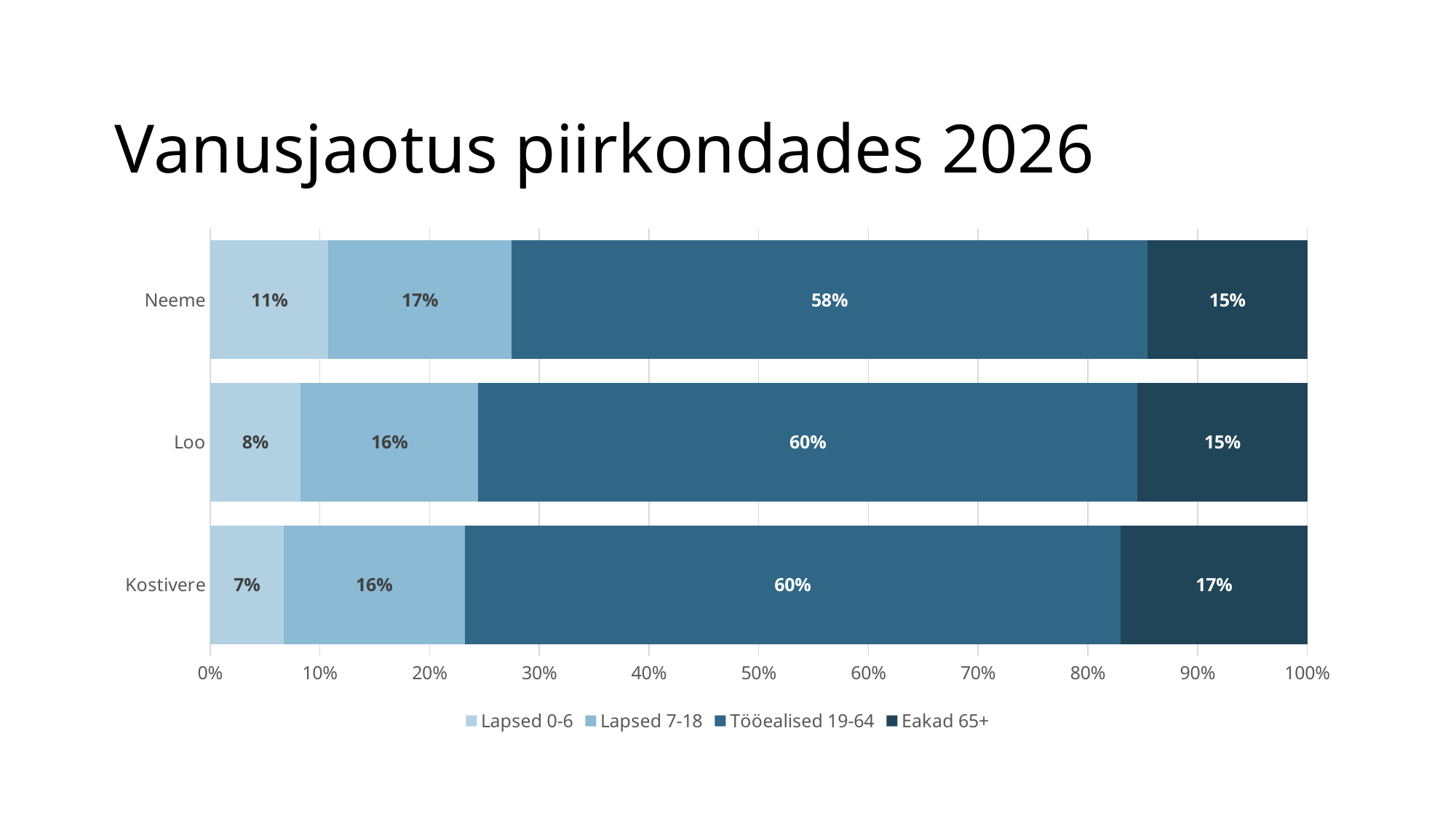
Which is larger: Eakad 65+ in Kostivere or Eakad 65+ in Loo? Kostivere What is the value for Eakad 65+ in Kostivere? 17% What is the value for Lapsed 7-18 in Kostivere? 16% How many series does the legend list? 4 What is the title of the chart? Vanusjaotus piirkondades 2026 What is the value for Lapsed 0-6 in Neeme? 11% Which region has the lowest value for Tööealised 19-64? Neeme What is the value for Tööealised 19-64 in Loo? 60% What kind of chart is shown on the slide? Stacked bar chart Which region has the highest value for Lapsed 0-6? Neeme How many regions are shown on the chart? 3 What is the difference between the Lapsed 0-6 values for Neeme and Kostivere? 4%